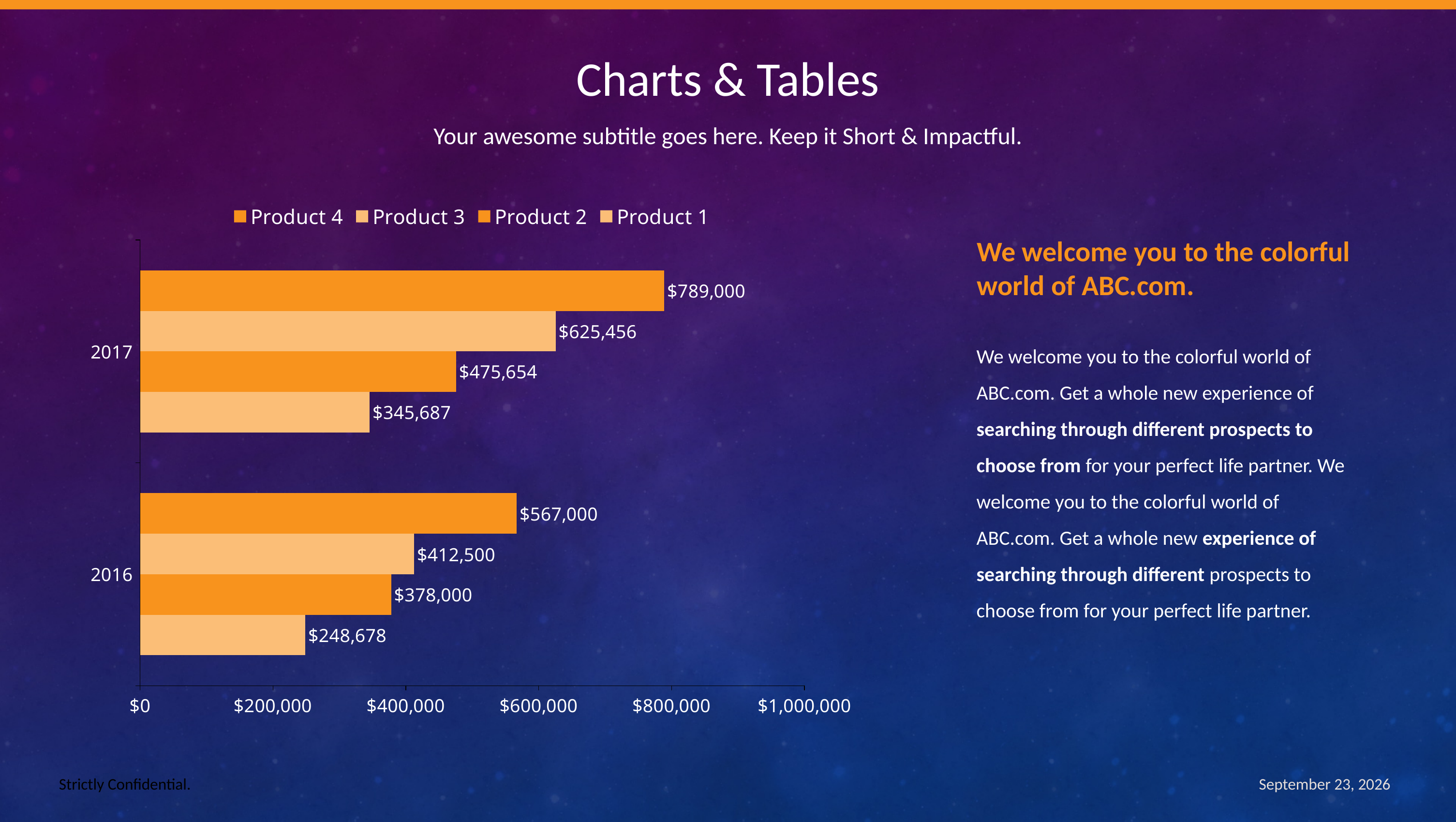
What is the value of the shortest bar in the 2016 group? $248,678 Is the value for Product 2 in 2016 greater or less than $400,000? less How many year categories are shown on the chart's vertical axis? 2 In 2016, which is larger: the bar labelled $412,500 or the bar labelled $378,000? $412,500 What is the value of the longest bar in the 2017 group? $789,000 What is the value for Product 3 in 2017? $625,456 Which series is listed first in the chart legend? Product 4 What kind of chart is shown on the slide? bar chart What is the lowest value shown on the chart? $248,678 What is the highest value shown on the chart? $789,000 What is the difference between the top bar of 2017 ($789,000) and the top bar of 2016 ($567,000)? $222,000 How many series does the chart legend list? 4